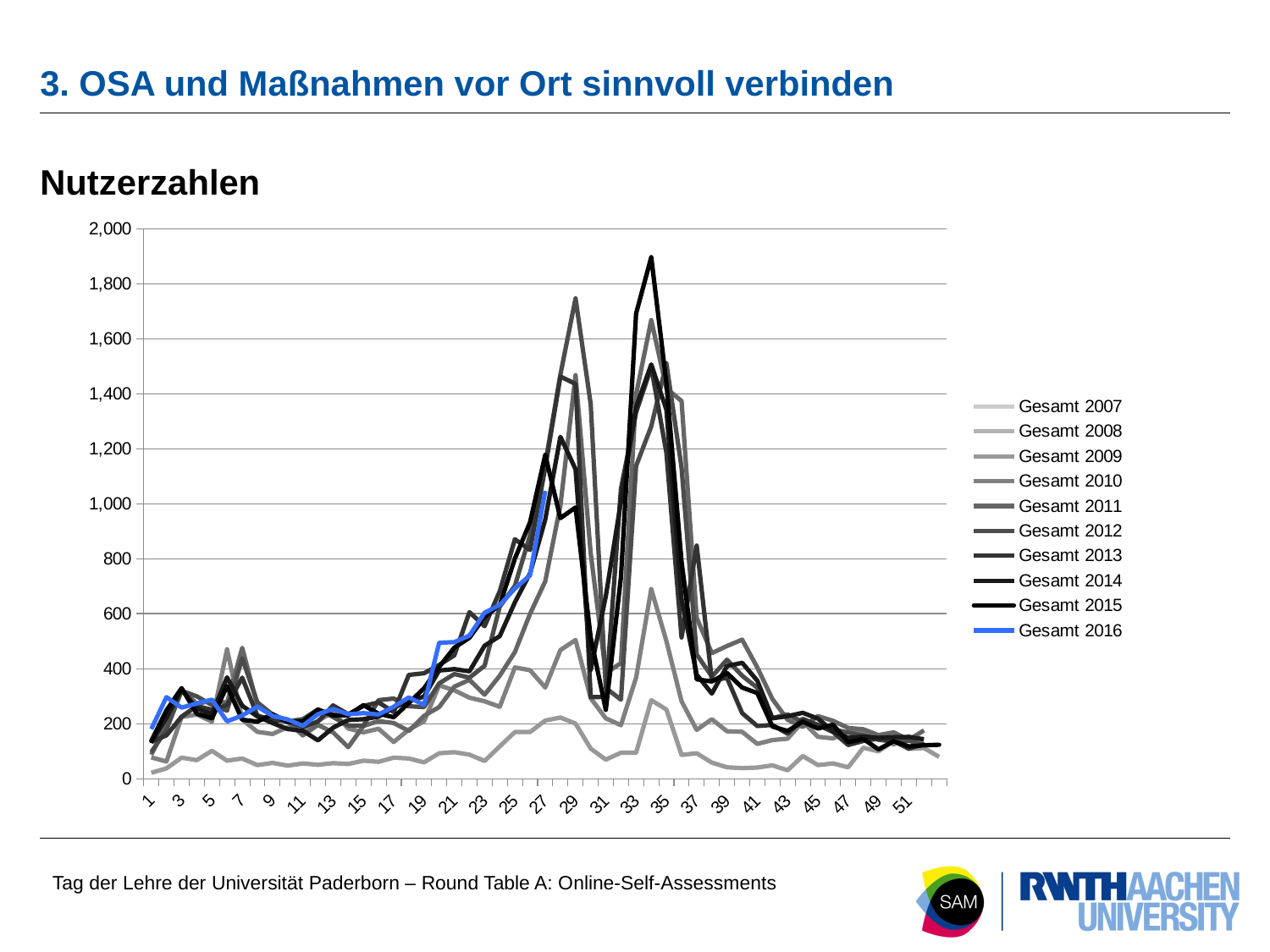
Is the highest peak of any series on the chart greater or less than 1,800? greater Which series is drawn in blue? Gesamt 2016 Is the value for Gesamt 2016 at x = 15 greater or less than 400? less Does the Gesamt 2016 line rise or fall between x = 20 and x = 27? rise How many series does the legend list? 10 Do the series generally rise or fall between x = 37 and x = 51? fall What is the highest value shown on the y axis? 2,000 What is the title of the chart? Nutzerzahlen Is the value for Gesamt 2016 at x = 25 greater or less than 600? greater What is the highest label shown on the x axis? 51 What kind of chart is shown on the slide? line chart